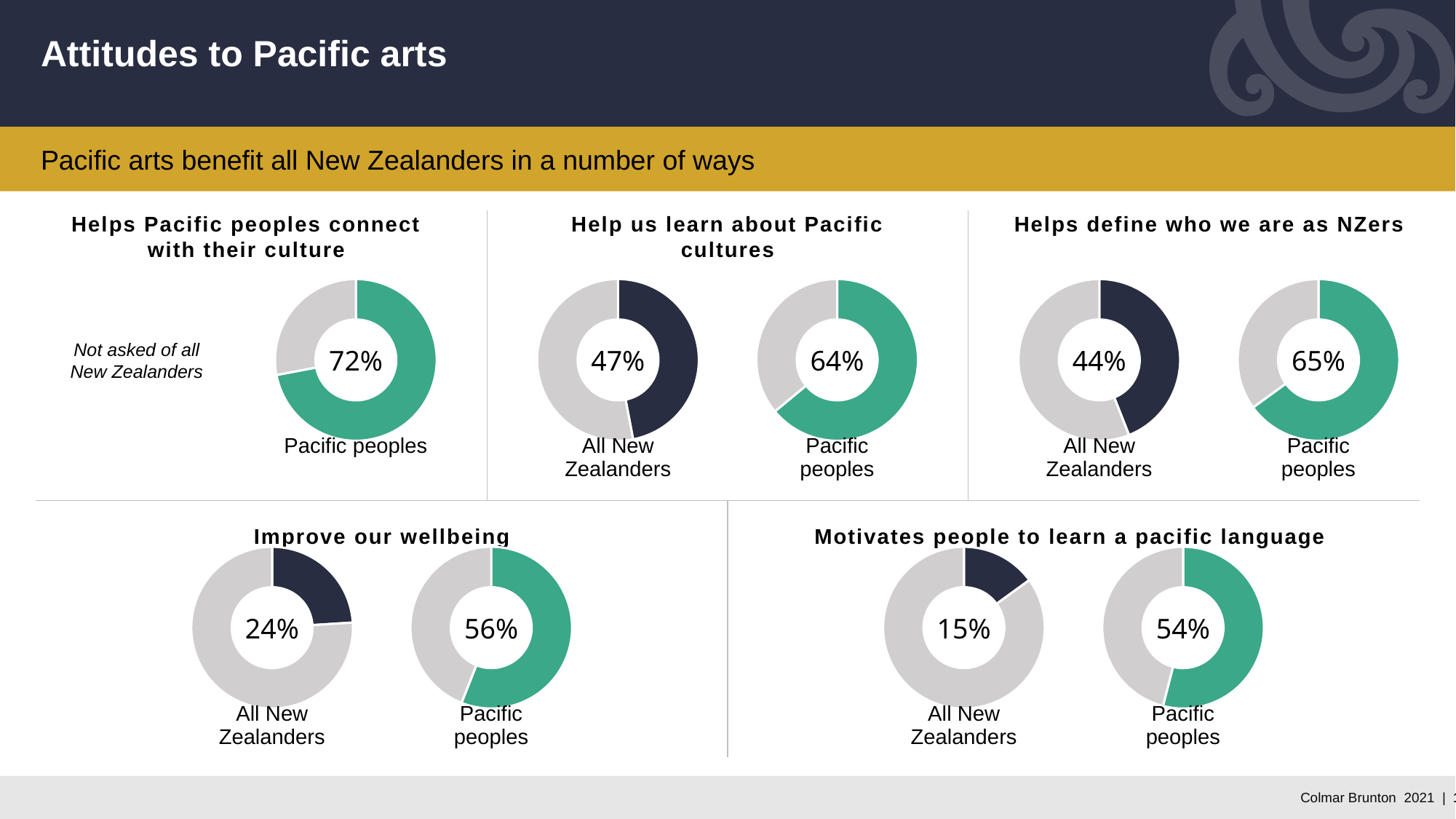
In the 'Helps Pacific peoples connect with their culture' chart, what percentage is shown for Pacific peoples? 72% In the 'Improve our wellbeing' charts, what percentage is shown for All New Zealanders? 24% Why is there only one chart under 'Helps Pacific peoples connect with their culture'? Not asked of all New Zealanders In the 'Help us learn about Pacific cultures' charts, what percentage is shown for All New Zealanders? 47% In the 'Helps define who we are as NZers' charts, which group has the higher percentage, All New Zealanders or Pacific peoples? Pacific peoples In the 'Improve our wellbeing' charts, what is the difference between the Pacific peoples and All New Zealanders percentages? 32 percentage points In the 'Help us learn about Pacific cultures' charts, what is the difference between the Pacific peoples and All New Zealanders percentages? 17 percentage points What type of chart is used to show the percentages on this slide? Donut (pie) chart Across all the charts on the slide, which statement has the highest percentage for Pacific peoples? Helps Pacific peoples connect with their culture In the 'Helps define who we are as NZers' charts, what percentage is shown for Pacific peoples? 65% Across all the charts on the slide, which statement has the lowest percentage for All New Zealanders? Motivates people to learn a pacific language In the 'Motivates people to learn a pacific language' charts, what percentage is shown for Pacific peoples? 54%